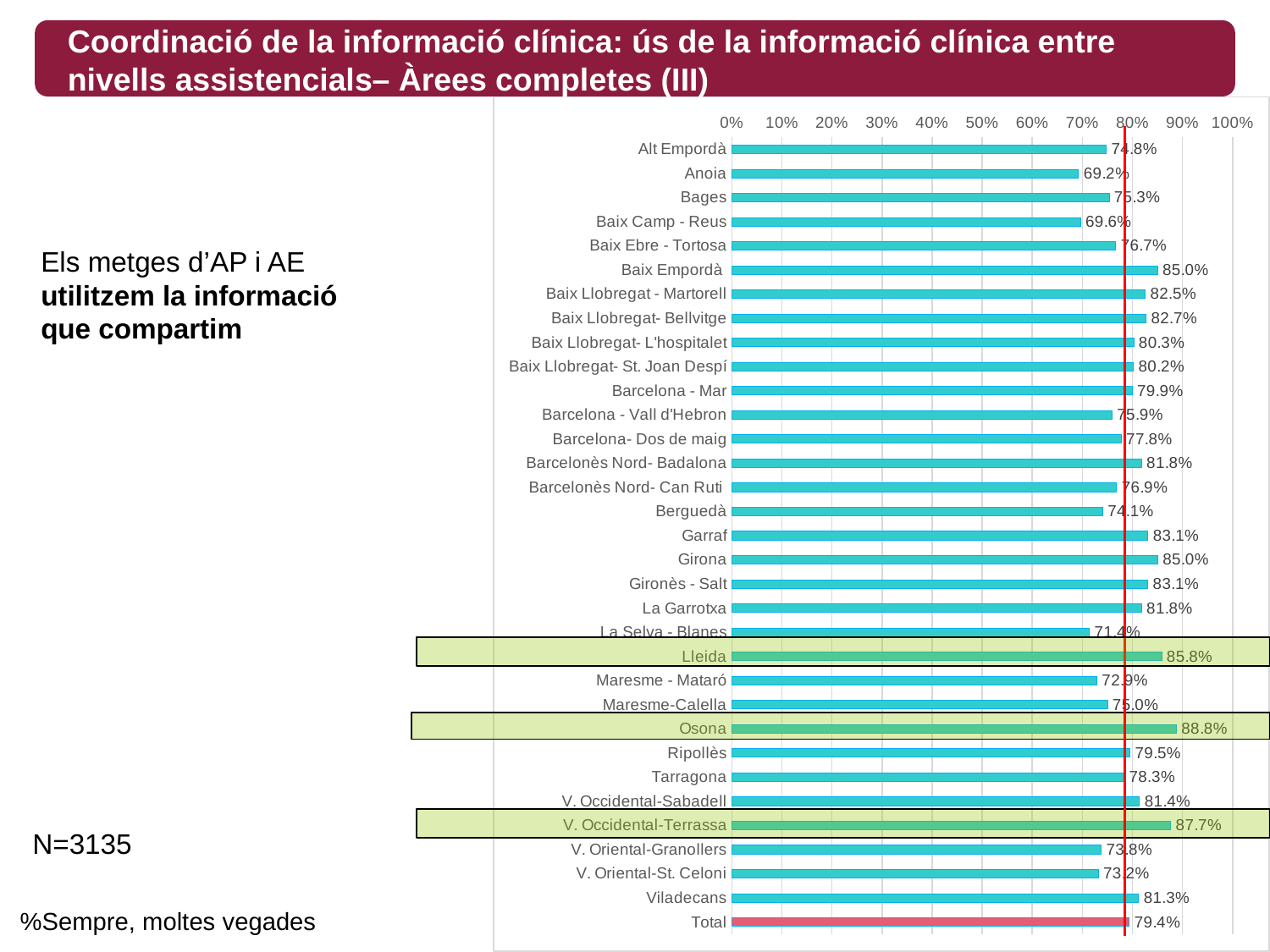
What is the value for the Total bar? 79.4% Is the value for Baix Empordà greater or less than 80%? greater Which area has the highest value? Osona What is the value for Osona? 88.8% What kind of chart is shown on the slide? bar chart Which has a larger value, Garraf or Tarragona? Garraf What is the value for Girona? 85.0% Which area has the lowest value? Anoia What is the difference between the values for Osona and Lleida? 3.0% What is the value for V. Occidental-Terrassa? 87.7% What is the value for Lleida? 85.8% How many bars are plotted in the chart, including Total? 33